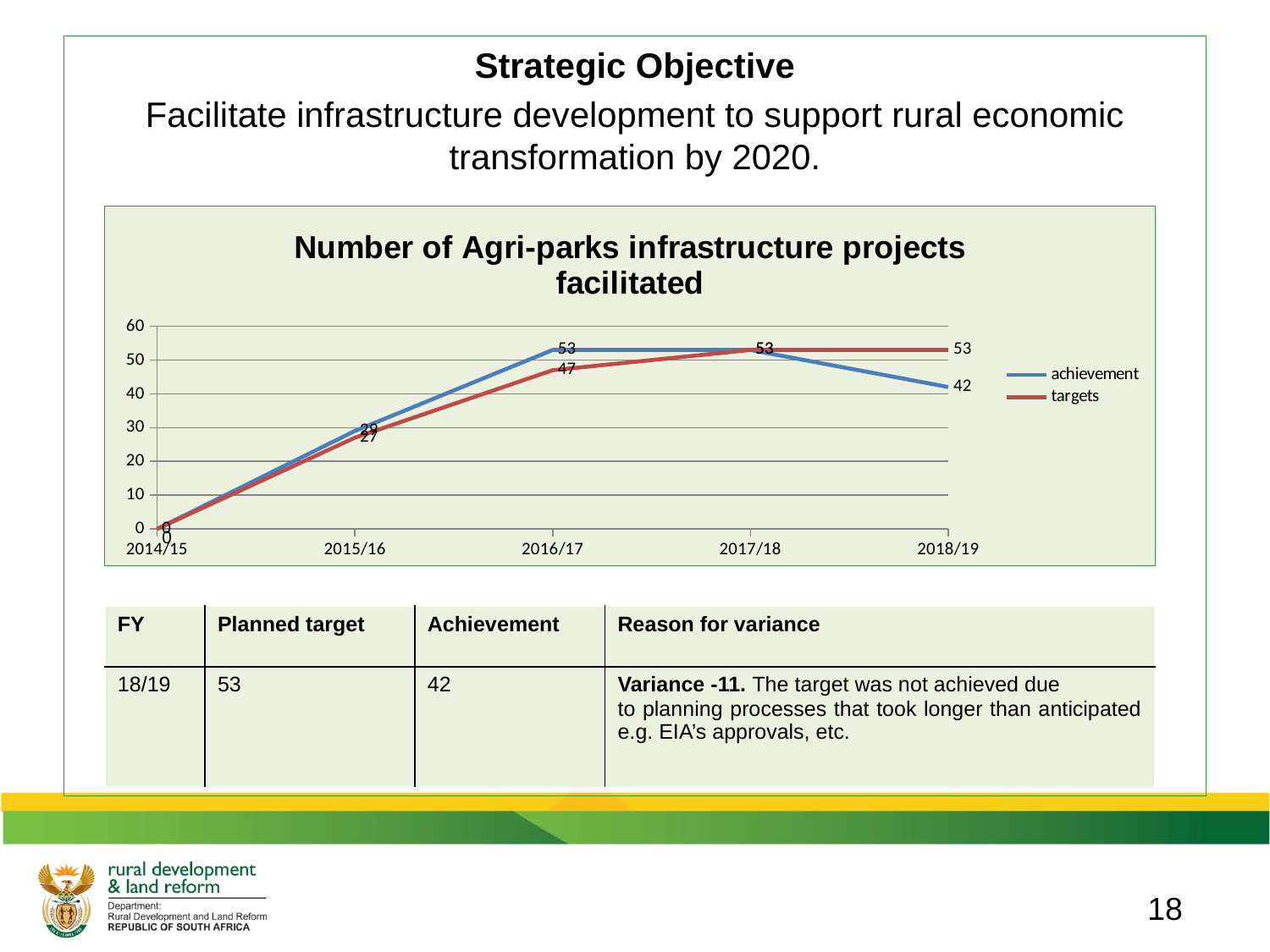
What is the targets value for 2016/17? 47 Does the achievement line rise or fall between 2017/18 and 2018/19? fall Which financial year has the lowest achievement value? 2014/15 What is the achievement value for 2018/19? 42 What kind of chart is shown on the slide? line chart What is the targets value for 2018/19? 53 How many financial years are plotted on the x axis? 5 What is the chart's title? Number of Agri-parks infrastructure projects facilitated How many series does the legend list? 2 What is the achievement value for 2015/16? 29 In 2016/17, which is larger, achievement or targets? achievement What is the difference between the targets and achievement values for 2018/19? 11